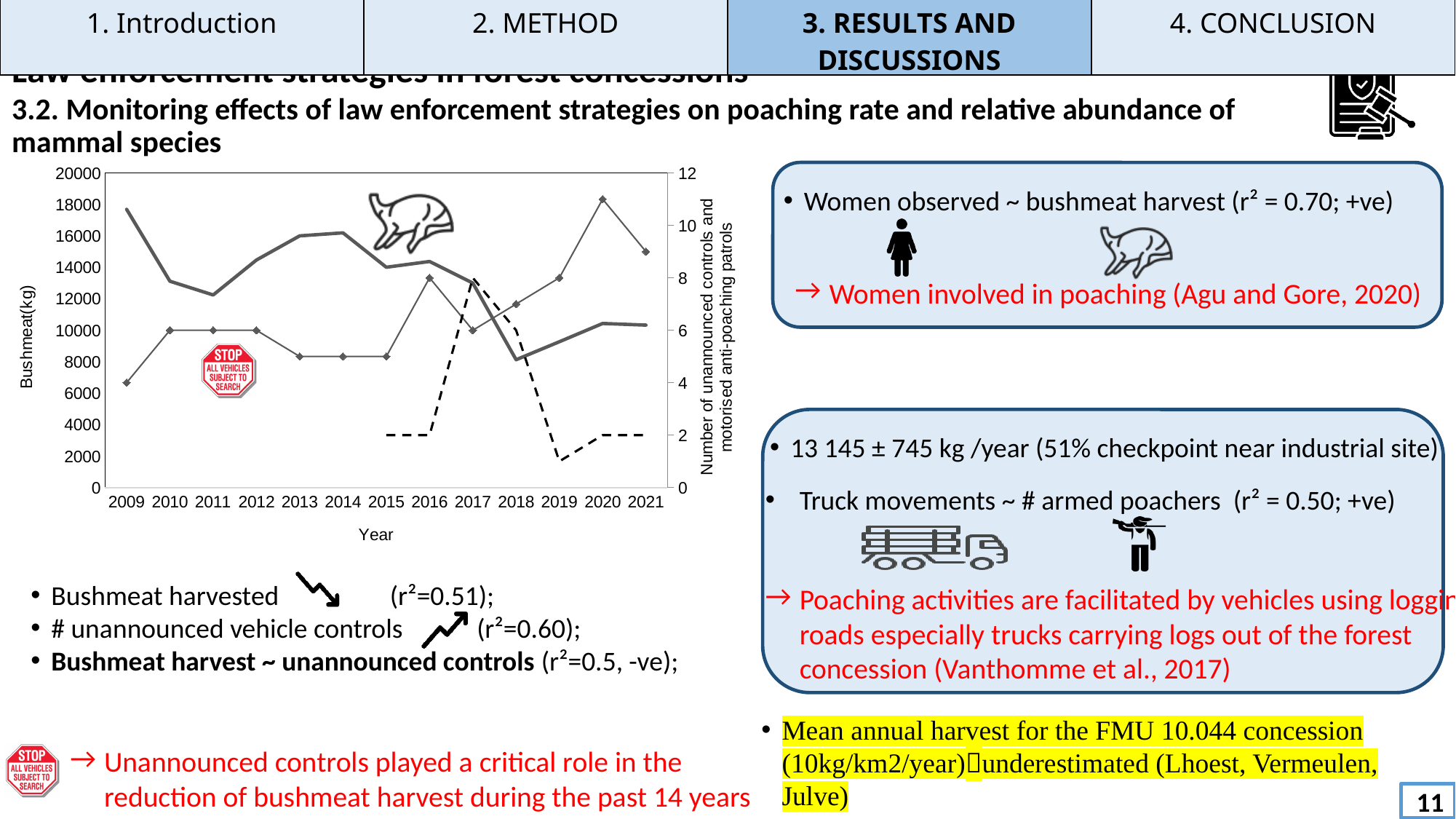
In which year does the thin line with diamond markers reach its highest value? 2020 How many years are plotted along the x axis of the chart? 13 Is the value of the thick grey line (bushmeat) in 2009 greater or less than 16000 on the left axis? greater What kind of chart is shown on the slide? line chart In which year does the thick grey line (bushmeat) reach its lowest value? 2018 In which year does the dashed line reach its lowest value? 2019 In which year does the thick grey line (bushmeat) reach its highest value? 2009 Which year has the larger value on the thick grey line (bushmeat): 2009 or 2021? 2009 What is the label of the horizontal axis of the chart? Year What is the label of the left vertical axis of the chart? Bushmeat(kg) Does the thick grey line (bushmeat) generally rise or fall from 2009 to 2021? fall Is the value of the thick grey line (bushmeat) in 2018 greater or less than 10000 on the left axis? less